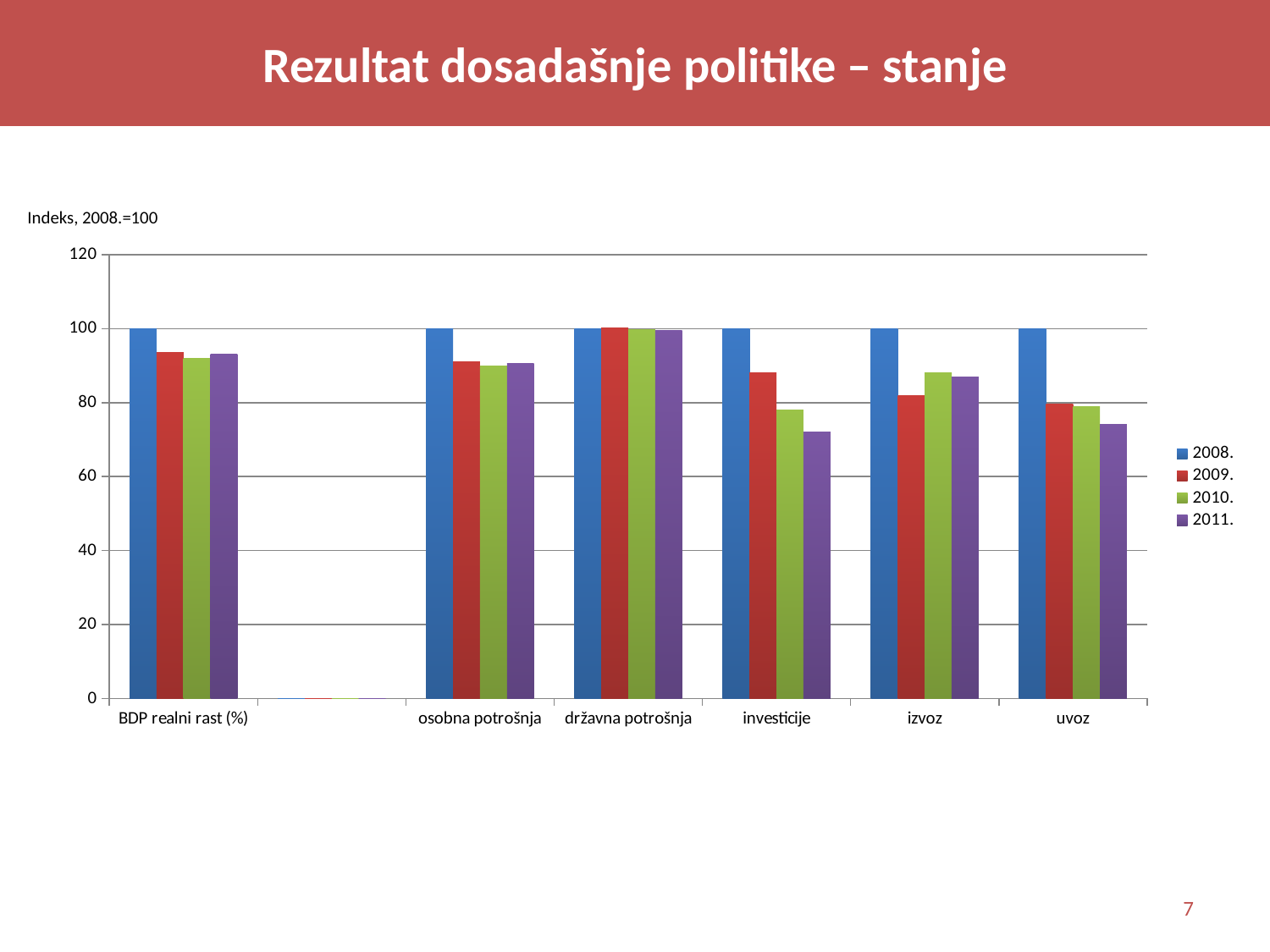
For investicije, do the values rise or fall from 2008. to 2011.? fall Is the value for osobna potrošnja in the 2009. series greater or less than 80? greater Is the value for uvoz in the 2011. series greater or less than 80? less What is the title of the slide containing the chart? Rezultat dosadašnje politike – stanje Is the value for investicije in the 2011. series greater or less than 80? less For investicije, which is larger: the 2009. value or the 2011. value? 2009. What kind of chart is shown on the slide? bar chart What is the value for izvoz in the 2008. series? 100 How many series does the legend list? 4 How many categories are labeled on the x axis? 6 What is the value for uvoz in the 2008. series? 100 Which category has the highest value in the 2011. series? državna potrošnja